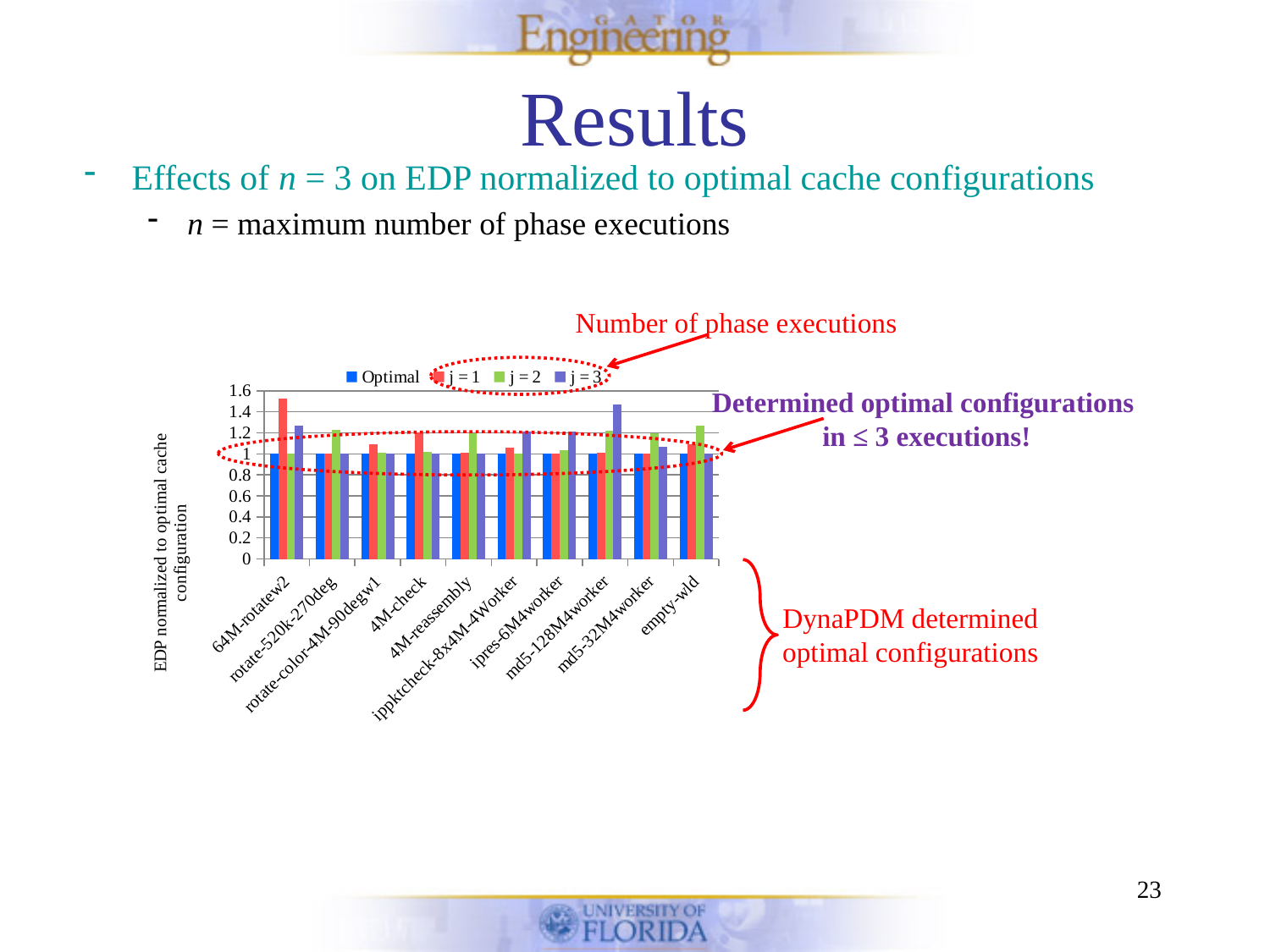
How many series does the chart legend list? 4 Is the j = 2 value for 4M-reassembly greater or less than 1? greater Is the j = 3 value for md5-128M4worker greater or less than 1.4? greater What is the first entry listed in the chart legend? Optimal Which category has the highest j = 3 bar? md5-128M4worker Is the j = 1 value for 64M-rotatew2 greater or less than 1.4? greater Which is larger, the j = 1 value for 64M-rotatew2 or the j = 1 value for rotate-520k-270deg? 64M-rotatew2 How many benchmark categories are shown along the x axis of the chart? 10 Which category has the highest j = 1 bar? 64M-rotatew2 What is the value of the Optimal series for 4M-check? 1 What kind of chart is shown on the slide? bar chart What is the label of the chart's y axis? EDP normalized to optimal cache configuration